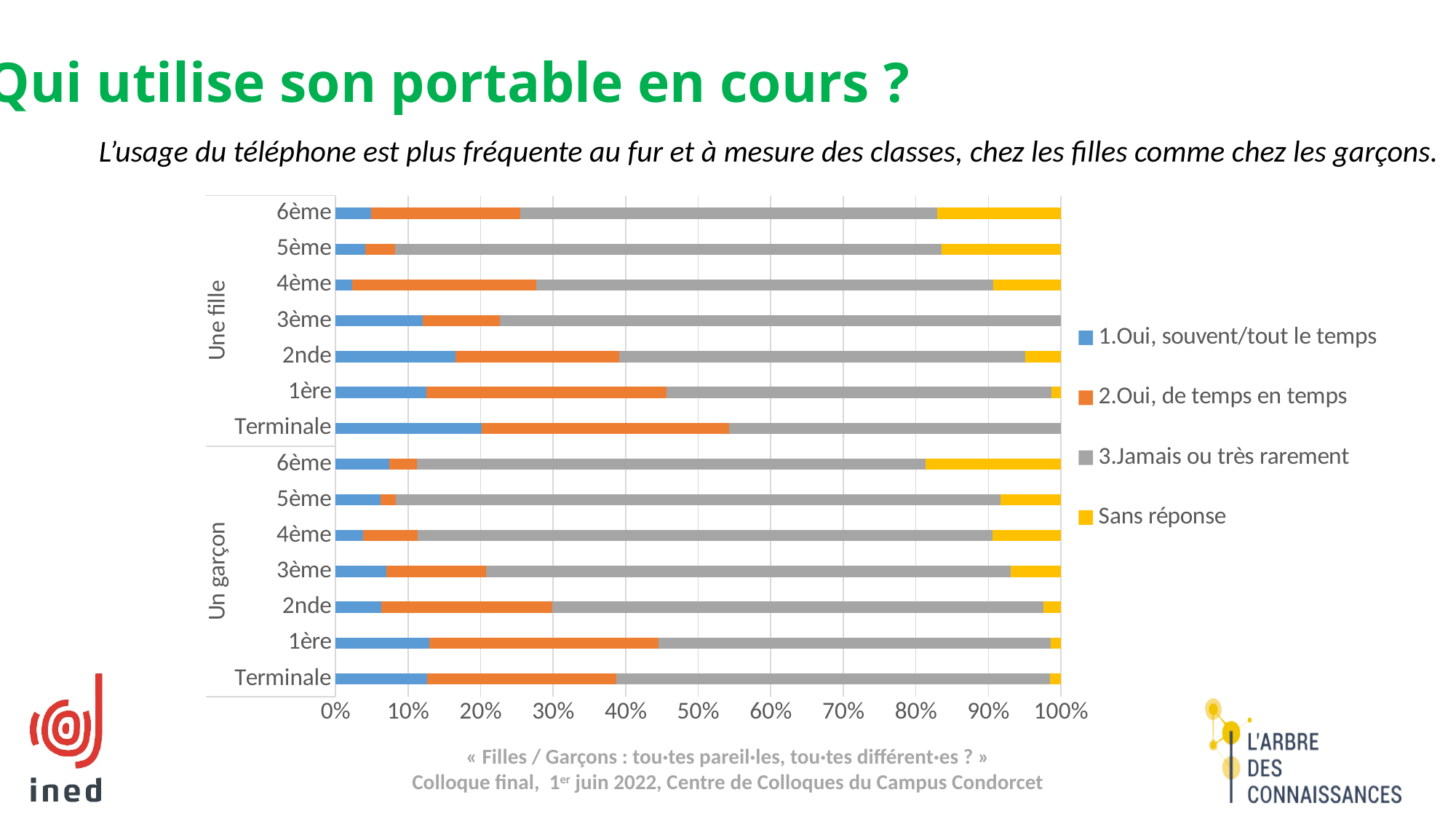
What kind of chart is shown on the slide? Stacked bar chart Which legend entry is shown in yellow? Sans réponse Among the Un garçon bars, which class has the largest '2.Oui, de temps en temps' segment? 1ère What is the title of the slide above the chart? Qui utilise son portable en cours ? Is the value for '1.Oui, souvent/tout le temps' for Une fille 6ème greater or less than 10%? less Is the value for '1.Oui, souvent/tout le temps' for Une fille 2nde greater or less than 10%? greater Is the value for '1.Oui, souvent/tout le temps' for Un garçon 1ère greater or less than 10%? greater Which has the larger '1.Oui, souvent/tout le temps' value: Une fille Terminale or Une fille 6ème? Une fille Terminale Among the Une fille bars, which class has the largest '1.Oui, souvent/tout le temps' segment? Terminale How many series does the legend list? 4 How many bars are plotted in the chart? 14